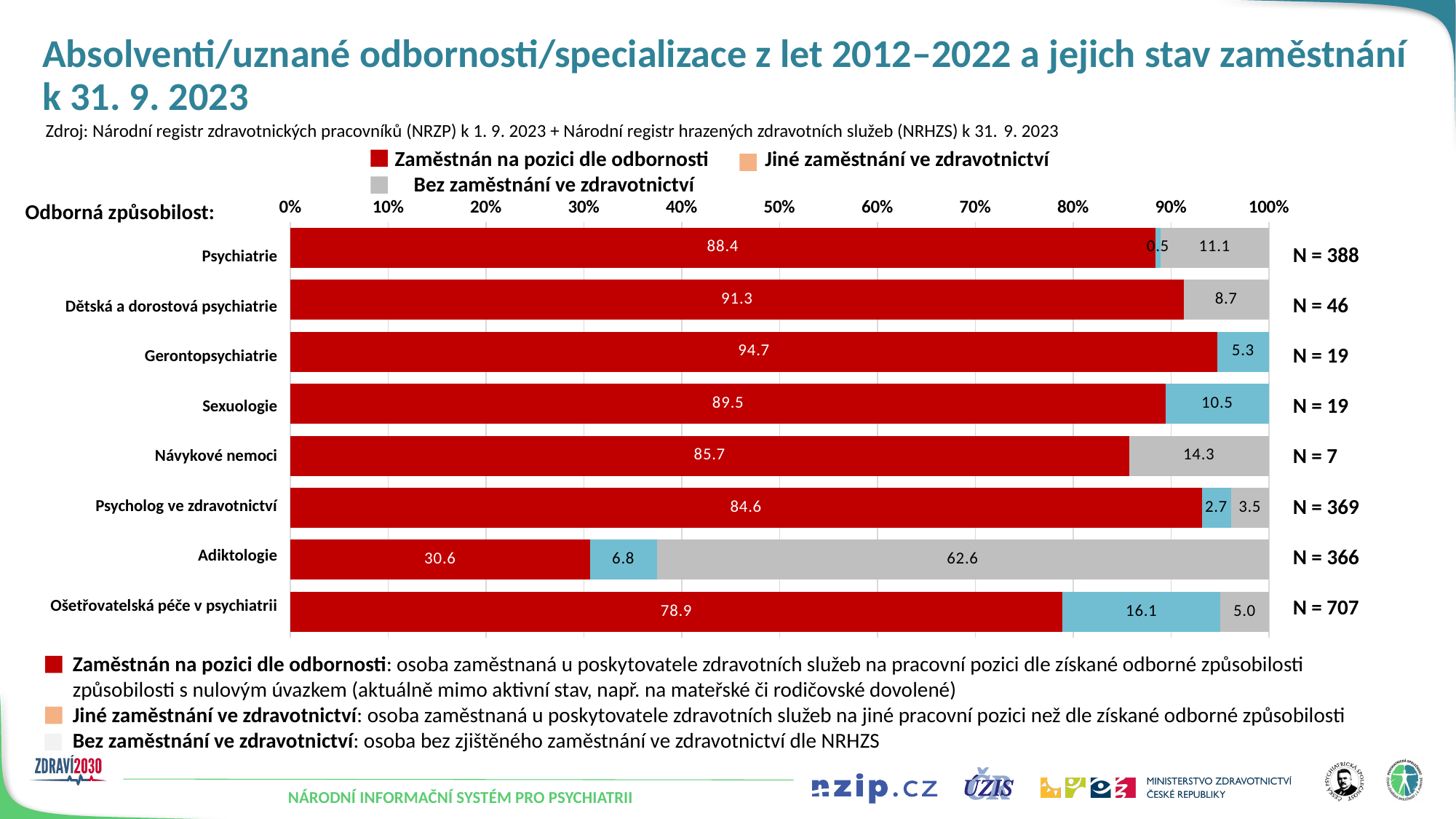
What is the N value shown for Ošetřovatelská péče v psychiatrii? N = 707 What kind of chart is shown on the slide? Stacked bar chart What percentage of Psychiatrie graduates are employed in a position matching their qualification (Zaměstnán na pozici dle odbornosti)? 88.4 What is the value of 'Bez zaměstnání ve zdravotnictví' for Adiktologie? 62.6 Which has a larger 'Bez zaměstnání ve zdravotnictví' share: Psychiatrie or Návykové nemoci? Návykové nemoci Which category has the highest share of 'Zaměstnán na pozici dle odbornosti'? Gerontopsychiatrie What is the total of the stacked bar for Adiktologie (30.6 + 6.8 + 62.6)? 100.0 How many series does the legend list? 3 What is the value of 'Jiné zaměstnání ve zdravotnictví' for Ošetřovatelská péče v psychiatrii? 16.1 How many categories (odborná způsobilost) are shown in the chart? 8 Which category has the lowest share of 'Zaměstnán na pozici dle odbornosti'? Adiktologie What is the difference between the 'Zaměstnán na pozici dle odbornosti' values for Dětská a dorostová psychiatrie and Psychiatrie? 2.9